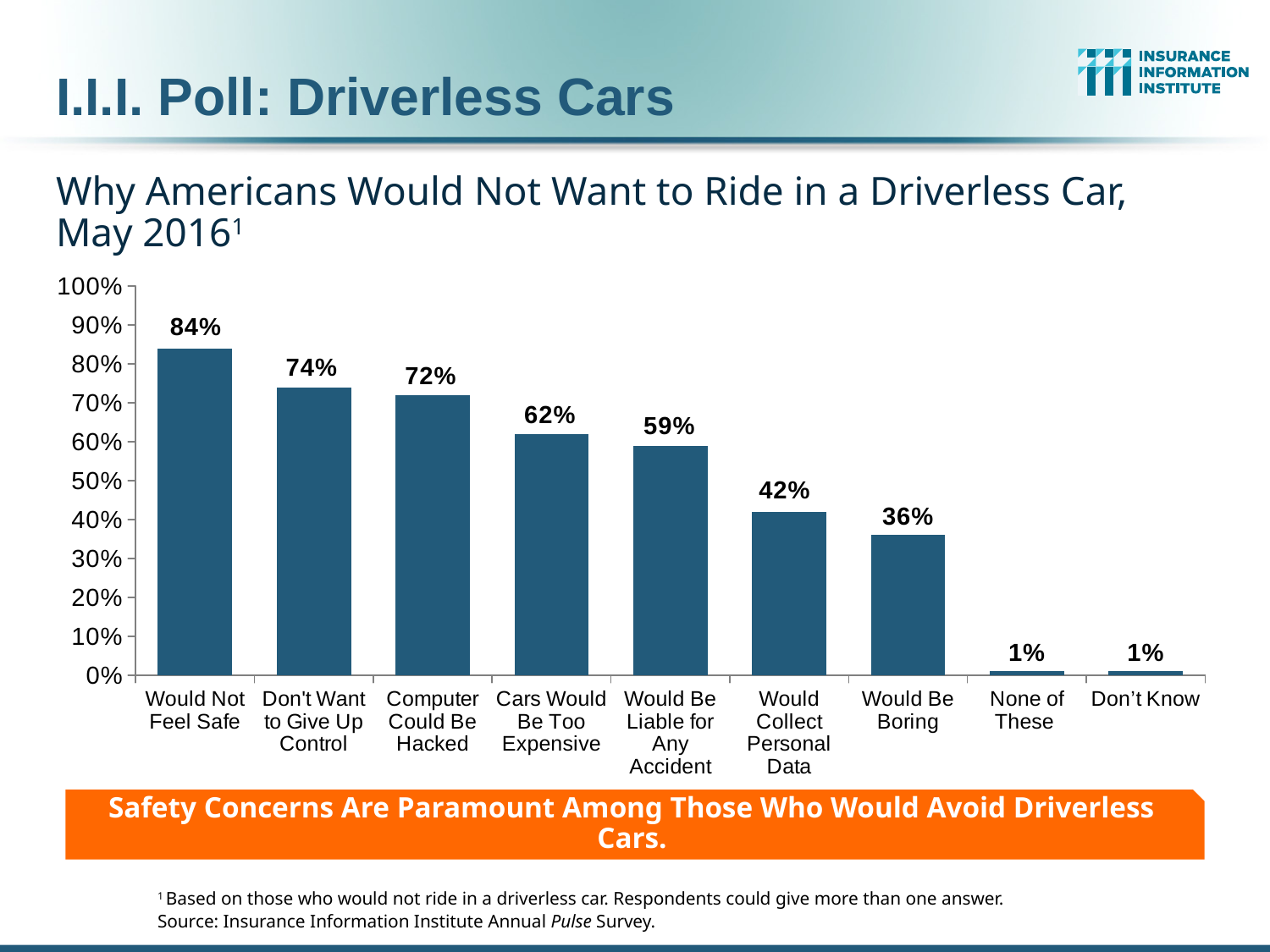
What is the difference between "Would Not Feel Safe" and "Don't Want to Give Up Control"? 10% How many categories are shown on the chart? 9 What is the value for "Computer Could Be Hacked"? 72% What is the title of the chart? Why Americans Would Not Want to Ride in a Driverless Car, May 2016 What percentage of respondents said they would not feel safe? 84% What kind of chart is shown on the slide? bar chart Which is larger, "Would Be Liable for Any Accident" or "Would Collect Personal Data"? Would Be Liable for Any Accident What is the difference between "Cars Would Be Too Expensive" and "Would Be Boring"? 26% What percentage cited "Would Collect Personal Data" as a reason? 42% Is the value for "Would Be Boring" greater or less than 40%? less Which reason has the highest percentage? Would Not Feel Safe Do the values rise or fall from left to right along the x axis? fall